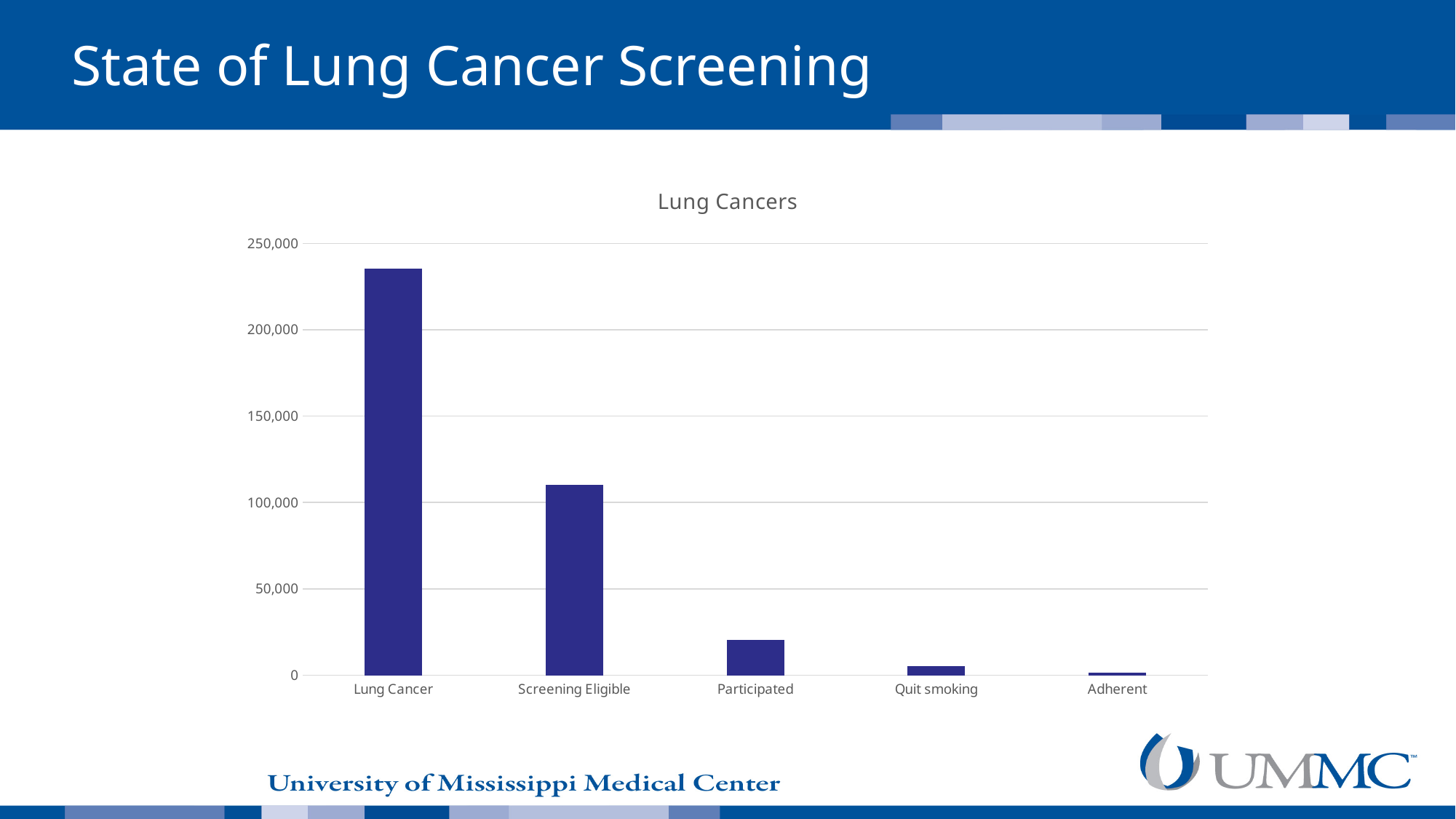
What is the highest value labelled on the vertical axis of the chart? 250,000 Is the value for Participated greater or less than 50,000? less What is the title of the chart? Lung Cancers Is the value for Screening Eligible greater or less than 100,000? greater Which category has the lowest value in the chart? Adherent Do the values rise or fall moving from left to right along the x axis? Fall Which is larger, the value for Screening Eligible or the value for Participated? Screening Eligible Which category has the highest value in the chart? Lung Cancer Is the value for Quit smoking greater or less than 50,000? less What kind of chart is shown on the slide? Bar chart How many categories are shown on the x axis of the chart? 5